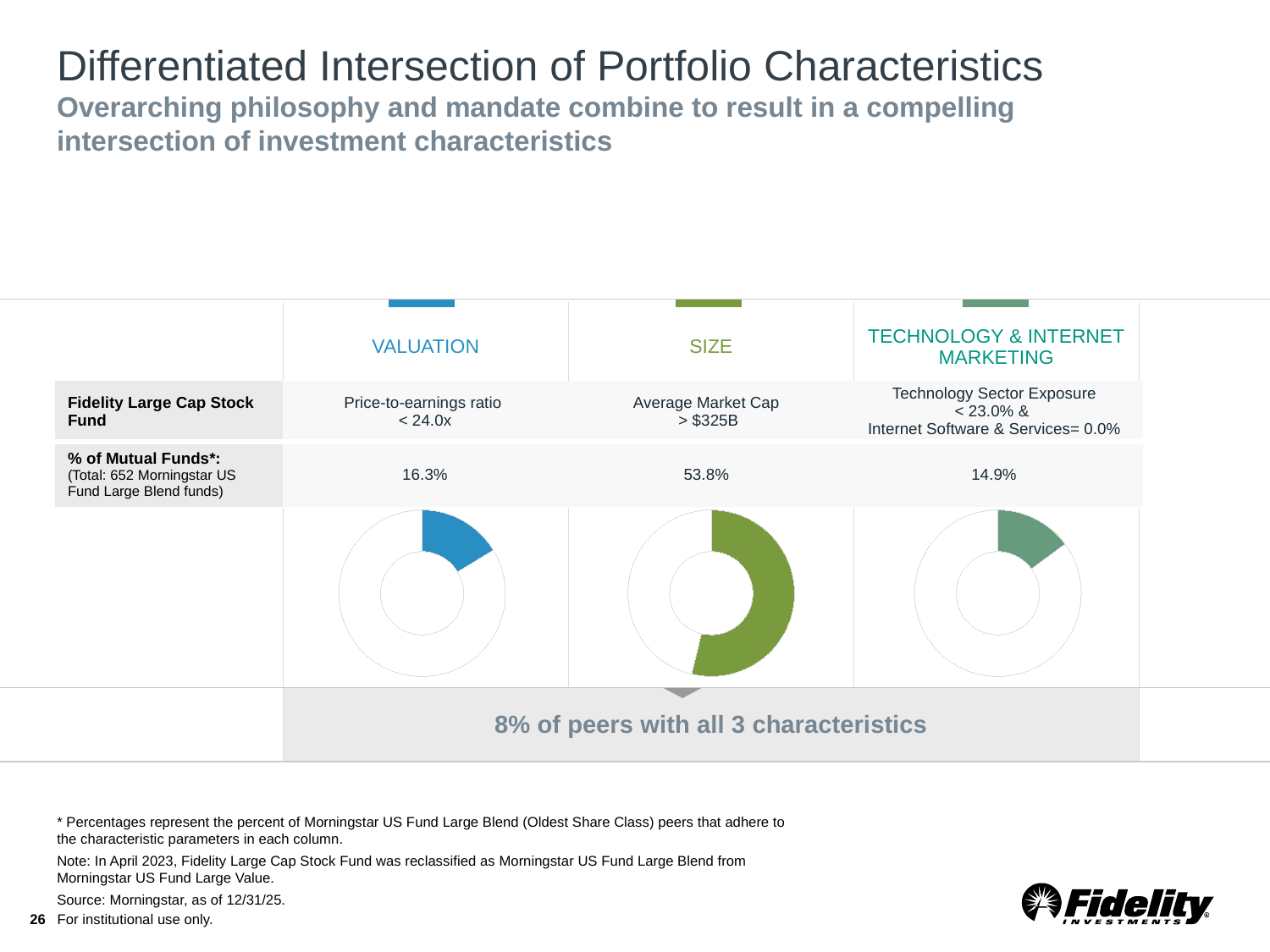
Which of the three characteristics (Valuation, Size, Technology & Internet Marketing) has the highest percentage of mutual funds? Size What colour is the filled segment of the Valuation donut chart? Blue How many donut charts are shown on the slide? 3 What is the difference in percentage points between the Valuation donut (16.3%) and the Technology & Internet Marketing donut (14.9%)? 1.4 percentage points What is the difference in percentage points between the Size donut (53.8%) and the Valuation donut (16.3%)? 37.5 percentage points What kind of chart is used under each of the three columns (Valuation, Size, Technology & Internet Marketing)? Donut chart What percentage of peers have all 3 characteristics, according to the bar below the donut charts? 8% Which of the three characteristics (Valuation, Size, Technology & Internet Marketing) has the lowest percentage of mutual funds? Technology & Internet Marketing Is the percentage of mutual funds for Size larger or smaller than the percentage for Valuation? Larger In the Valuation column, what percentage of mutual funds have a price-to-earnings ratio below 24.0x? 16.3% In the Size column, what percentage of mutual funds have an average market cap above $325B? 53.8% In the Technology & Internet Marketing column, what percentage of mutual funds meet the technology sector exposure criteria? 14.9%